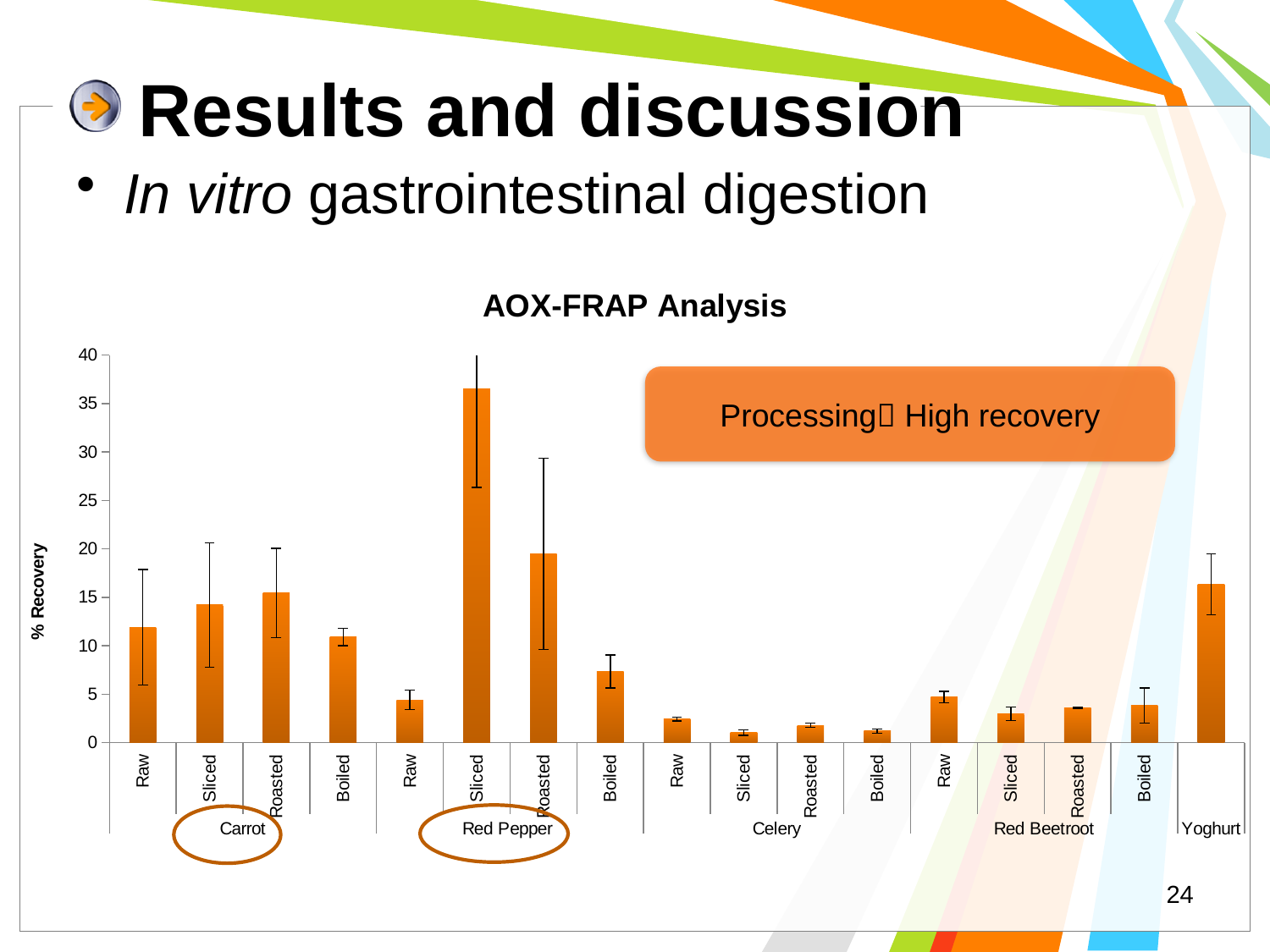
Is the value for Yoghurt greater or less than 10? greater Is the value for Red Pepper Roasted greater or less than 15? greater Which has a higher % Recovery, Yoghurt or Red Beetroot Raw? Yoghurt What is the title of the chart? AOX-FRAP Analysis Is the value for Celery Raw greater or less than 5? less What is the label on the vertical axis of the chart? % Recovery Which bar has the highest % Recovery in the chart? Red Pepper Sliced How many bars are plotted in the chart? 17 What kind of chart is shown on the slide? bar chart Which has a higher % Recovery, Red Pepper Sliced or Carrot Roasted? Red Pepper Sliced